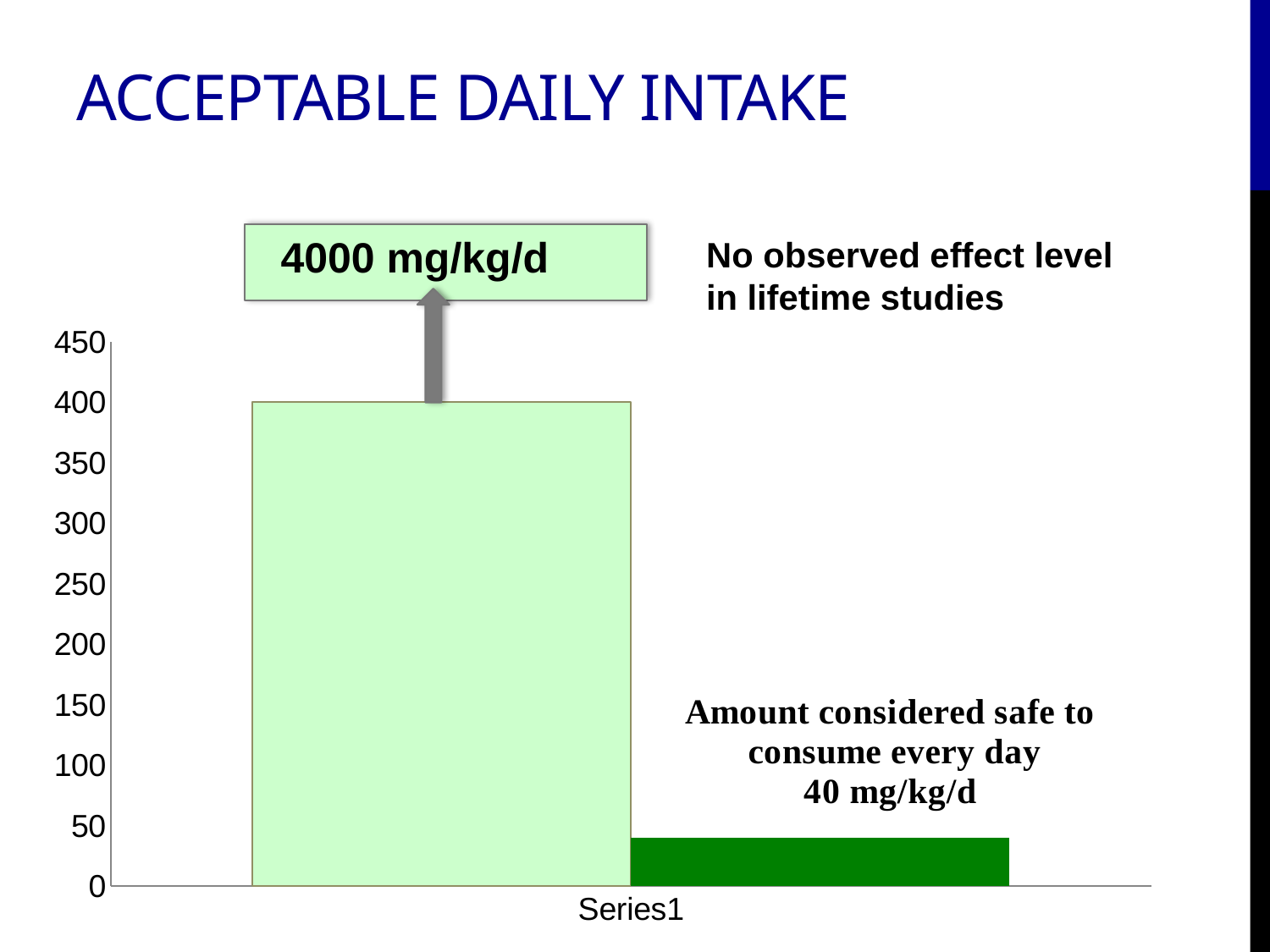
Which bar has the lowest value in the chart? the dark green bar How many bars are plotted in the chart? 2 Is the value of the dark green bar greater or less than 50? less What value does the light green bar reach on the y axis? 400 Is the value of the light green bar greater or less than 350? greater What kind of chart is shown on the slide? bar chart What is the category label shown on the x axis? Series1 What is the highest tick value shown on the y axis? 450 Which bar is taller, the light green bar or the dark green bar? the light green bar